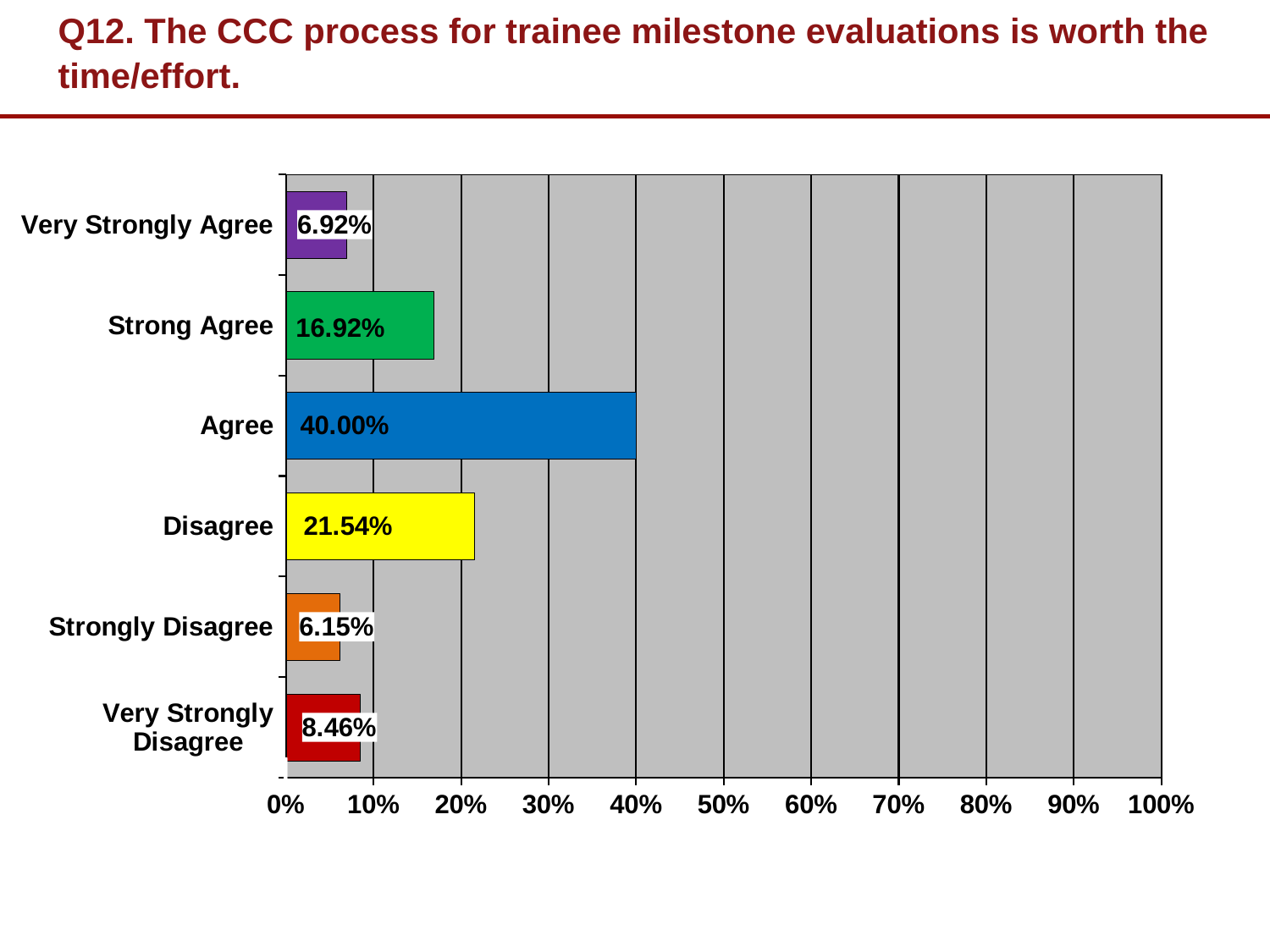
Which response category has the highest percentage? Agree What is the value shown for "Very Strongly Agree"? 6.92% Which is larger, the value for "Strong Agree" or the value for "Disagree"? Disagree What kind of chart is shown on the slide? Bar chart What is the difference between the "Agree" and "Disagree" percentages? 18.46% How many response categories are shown on the chart? 6 What colour is the bar for "Agree"? Blue Is the value for "Disagree" greater or less than 20%? greater Which response category has the lowest percentage? Strongly Disagree What percentage is shown for "Strongly Disagree"? 6.15% What is the value for "Very Strongly Disagree"? 8.46% What percentage of respondents chose "Agree"? 40.00%